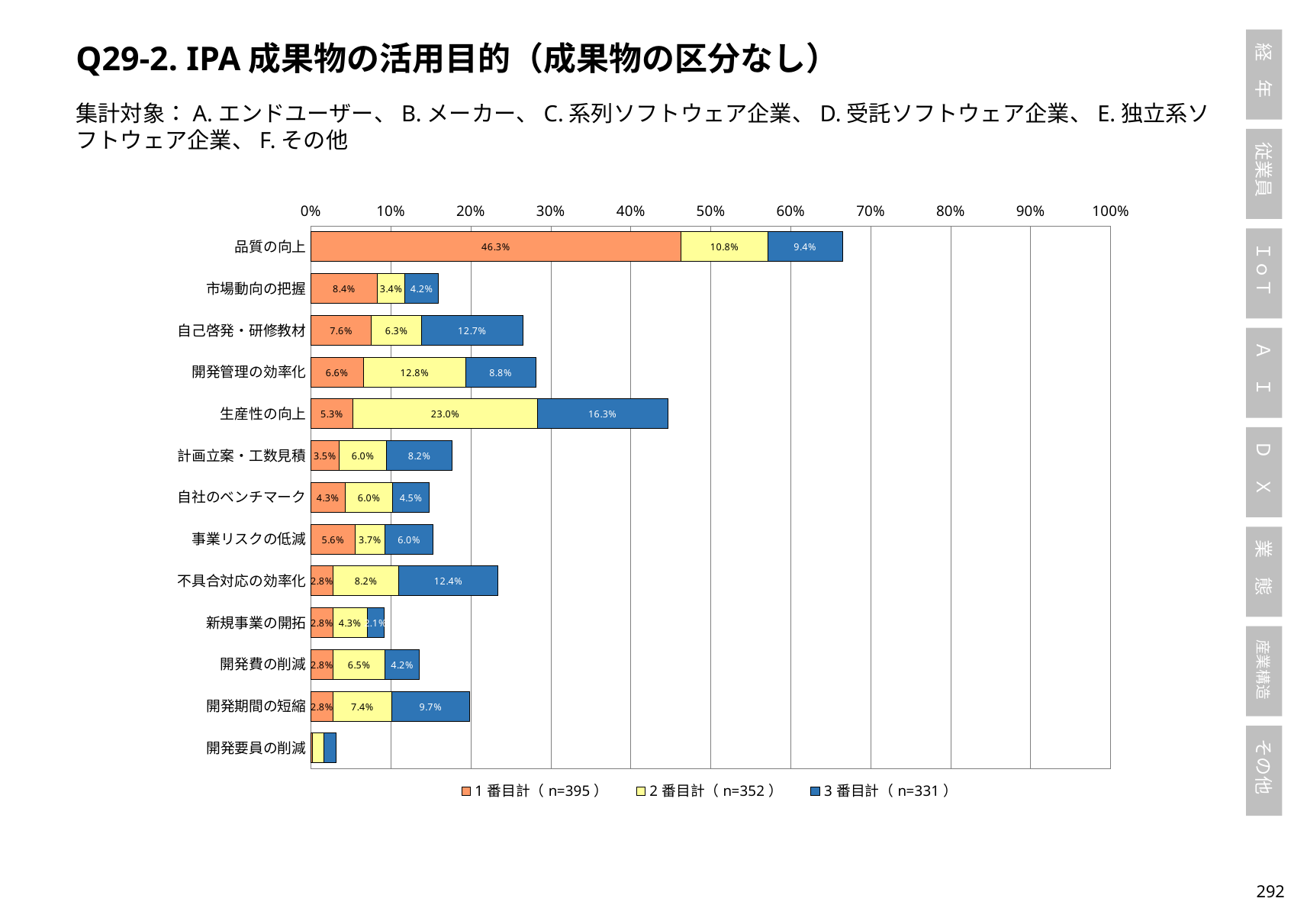
What is the value of 1番目計 for 品質の向上? 46.3% Is the total stacked bar for 生産性の向上 greater or less than 40%? greater What is the value of 2番目計 for 生産性の向上? 23.0% What is the total of the stacked bar for 品質の向上? 66.5% What type of chart is shown on the slide? Stacked bar chart What is the n value shown in the legend for 1番目計? n=395 Which category has the highest 1番目計 value? 品質の向上 Which is larger: the 2番目計 value for 開発管理の効率化 or for 不具合対応の効率化? 開発管理の効率化 How many categories are plotted on the chart? 13 What is the difference between the 3番目計 values for 生産性の向上 and 開発管理の効率化? 7.5% How many series does the legend list? 3 What is the value of 3番目計 for 自己啓発・研修教材? 12.7%